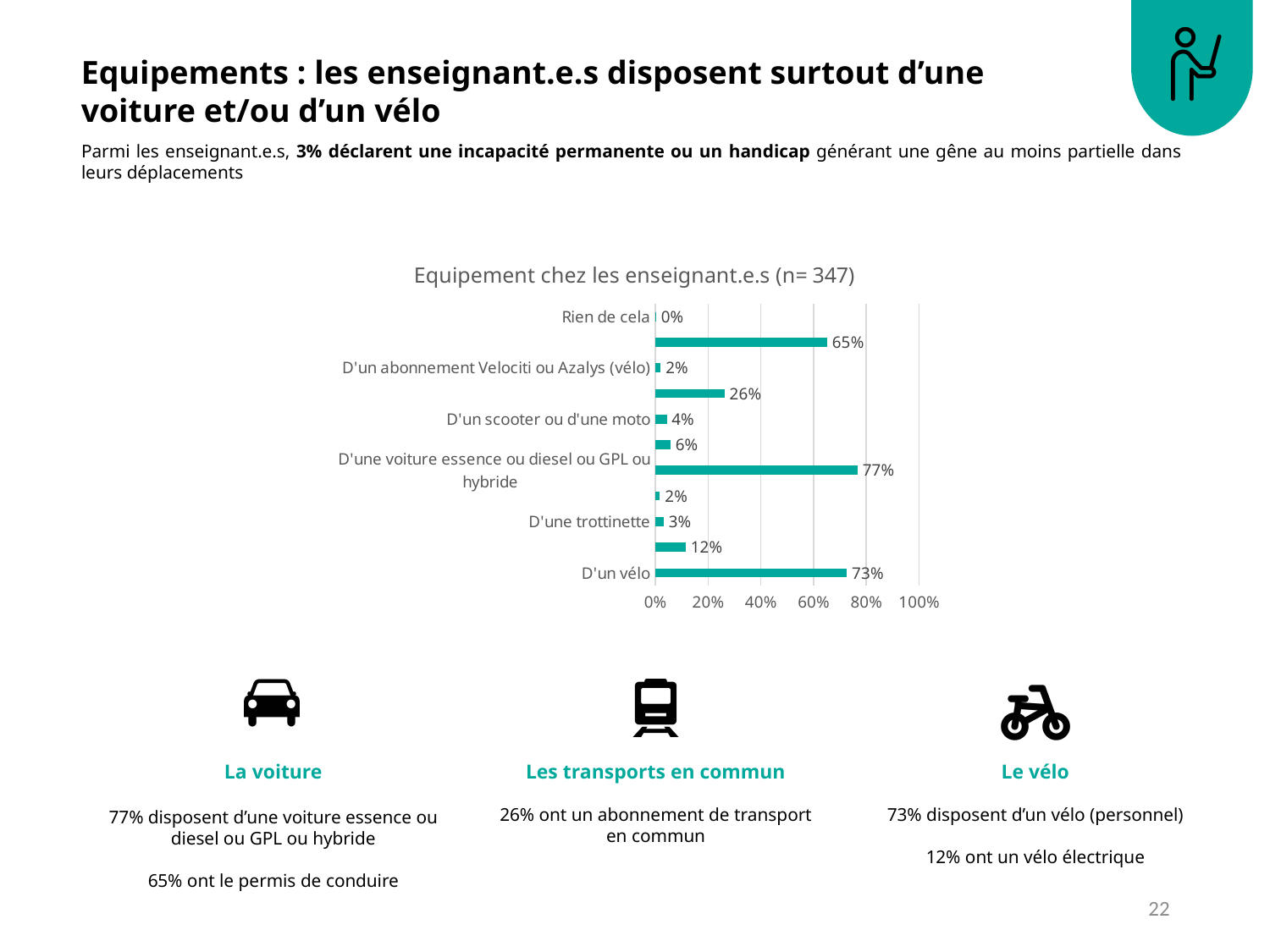
What is the value for 'D'un vélo'? 73% What type of chart is shown on the slide? Bar chart What is the value for 'D'une voiture essence ou diesel ou GPL ou hybride'? 77% Which category has the highest value in the chart? D'une voiture essence ou diesel ou GPL ou hybride What is the difference between the value for 'D'une voiture essence ou diesel ou GPL ou hybride' and the value for 'D'un vélo'? 4% What is the value for 'D'un abonnement Velociti ou Azalys (vélo)'? 2% Which is larger: the value for 'D'un scooter ou d'une moto' or the value for 'D'une trottinette'? D'un scooter ou d'une moto What is the value for 'D'une trottinette'? 3% What is the value for 'D'un scooter ou d'une moto'? 4% What is the title of the chart? Equipement chez les enseignant.e.s (n= 347) How many bars are plotted in the chart? 11 What is the value for 'Rien de cela'? 0%